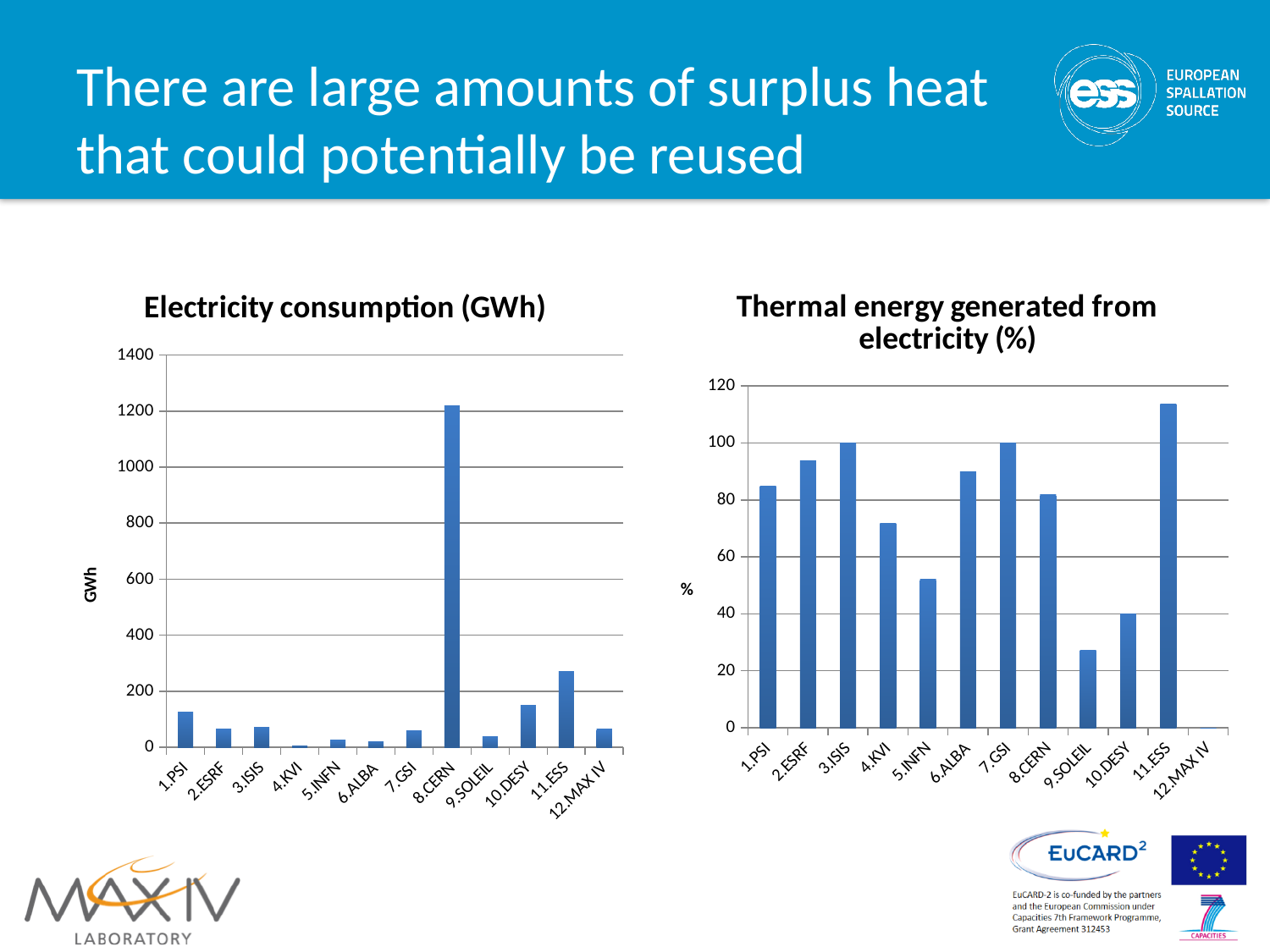
What is the y-axis label of the 'Electricity consumption (GWh)' chart? GWh In the 'Thermal energy generated from electricity (%)' chart, is the value for 9.SOLEIL greater or less than 40? less In the 'Electricity consumption (GWh)' chart, which is larger, the value for 10.DESY or the value for 2.ESRF? 10.DESY In the 'Electricity consumption (GWh)' chart, is the value for 8.CERN greater or less than 1200? greater In the 'Electricity consumption (GWh)' chart, is the value for 11.ESS greater or less than 200? greater How many facilities are shown on the x axis of the 'Electricity consumption (GWh)' chart? 12 What kind of chart is the 'Electricity consumption (GWh)' chart? bar chart In the 'Thermal energy generated from electricity (%)' chart, what is the value for 3.ISIS? 100 In the 'Thermal energy generated from electricity (%)' chart, which is larger, the value for 4.KVI or the value for 5.INFN? 4.KVI In the 'Thermal energy generated from electricity (%)' chart, which facility has the lowest value? 12.MAX IV In the 'Thermal energy generated from electricity (%)' chart, which facility has the highest value? 11.ESS In the 'Electricity consumption (GWh)' chart, which facility has the highest electricity consumption? 8.CERN